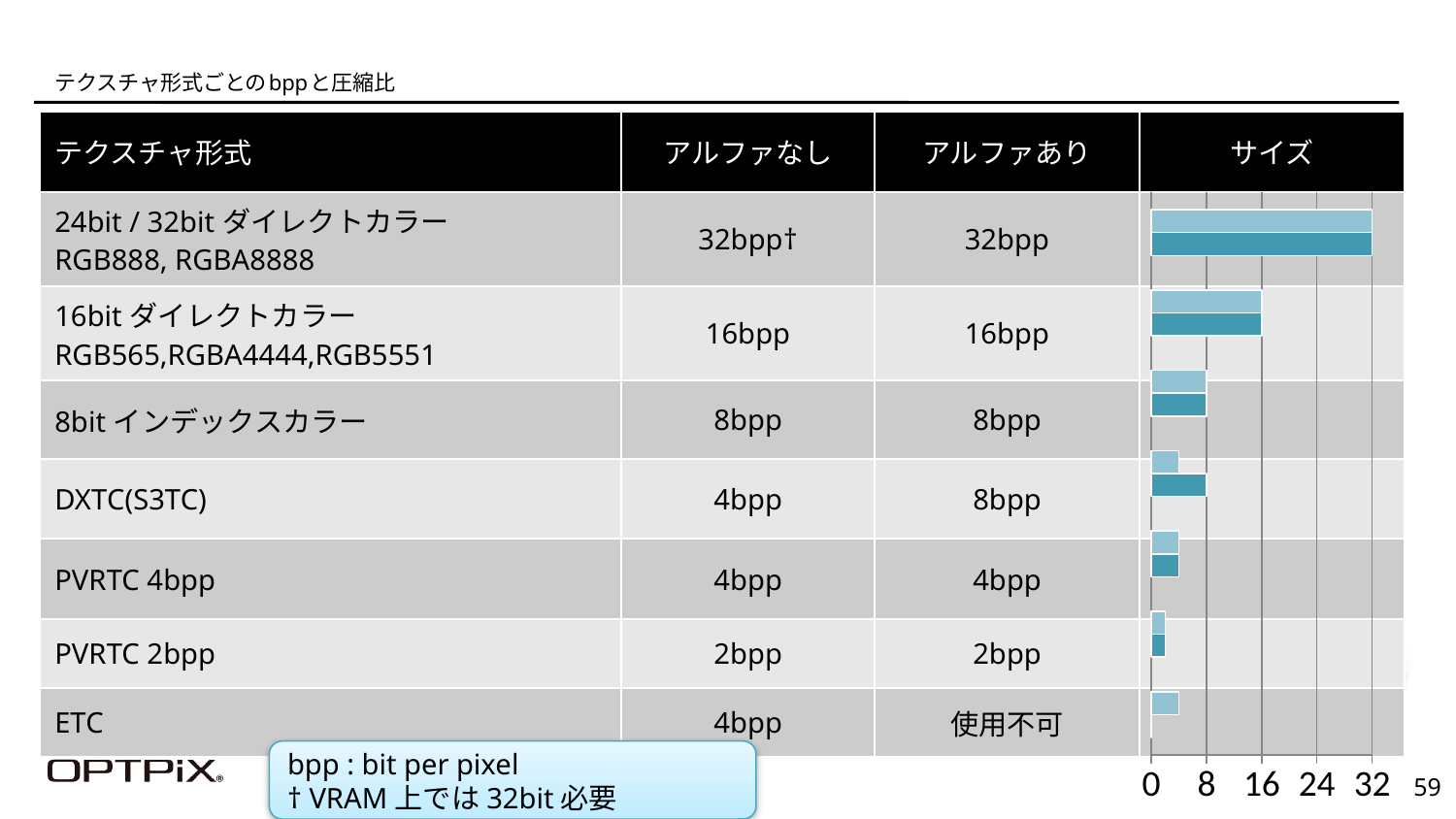
What is the difference between the アルファあり and アルファなし values for DXTC(S3TC)? 4bpp What is the highest value shown on the axis of the サイズ bar chart? 32 What is the difference between the アルファなし values of 24bit / 32bit ダイレクトカラー and 16bit ダイレクトカラー? 16bpp Which has a larger アルファなし value, 16bit ダイレクトカラー or 8bit インデックスカラー? 16bit ダイレクトカラー How many texture formats are listed in the table? 7 Do the bar sizes increase or decrease going down the table from the first row to the last? decrease What is the アルファなし value for ETC? 4bpp Is the bar for 24bit / 32bit ダイレクトカラー greater or less than 24 on the axis? greater What kind of chart is shown in the サイズ column of the table? bar chart Which texture format has the smallest bars in the サイズ column? PVRTC 2bpp What is the アルファあり value for DXTC(S3TC)? 8bpp Which texture format has the largest bar in the サイズ column? 24bit / 32bit ダイレクトカラー